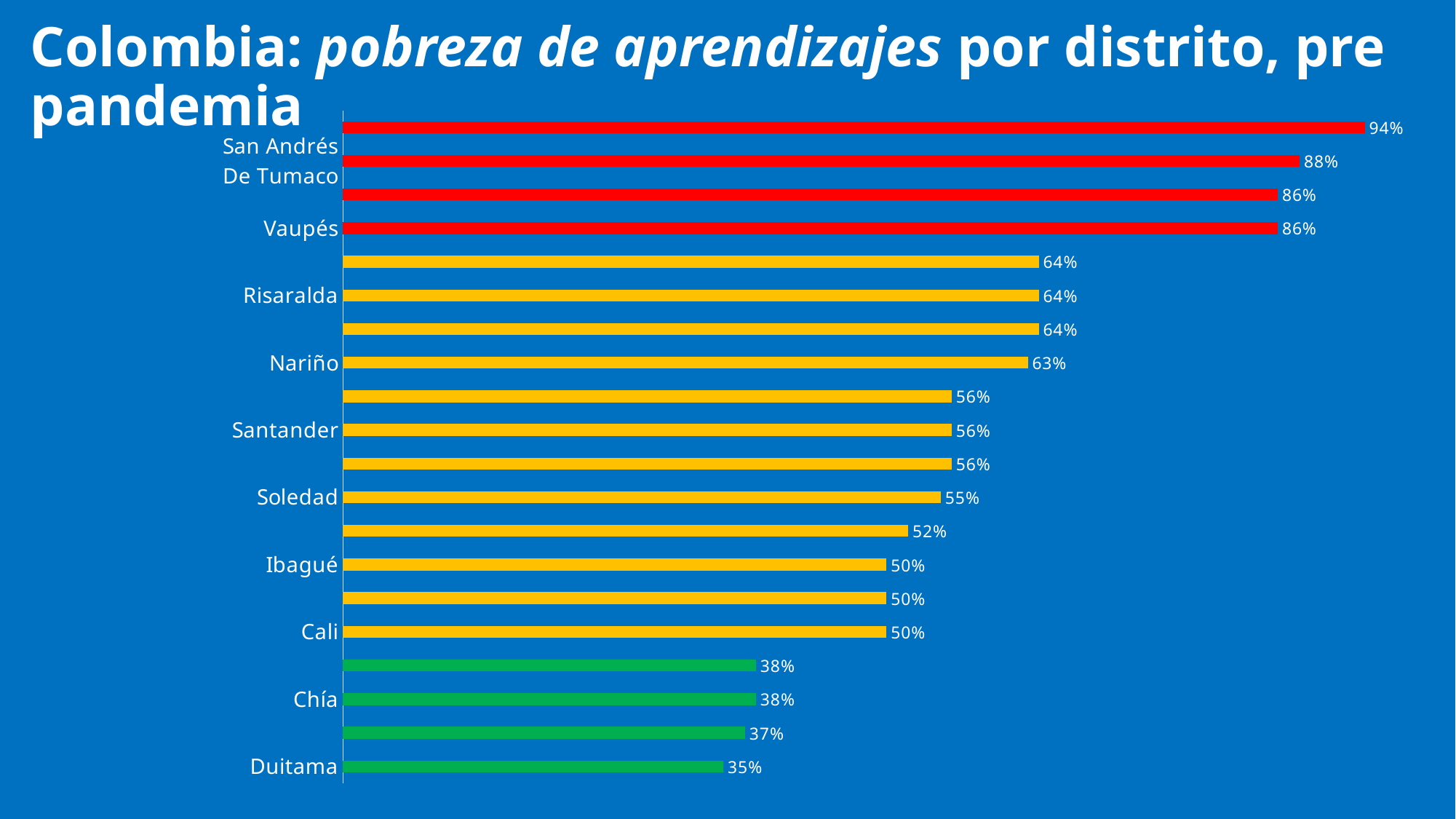
What is the value for Duitama? 35% What is the difference between the values for Risaralda and Cali? 14 percentage points How many bars are plotted in the chart? 20 Which is larger, the value for Soledad or the value for Ibagué? Soledad What is the value for Santander? 56% What is the value for Nariño? 63% What kind of chart is shown on the slide? Bar chart What colour is the bar for Duitama? Green What is the value for Risaralda? 64% What is the value for Vaupés? 86% What is the value for Cali? 50% Which labelled district has the lowest value? Duitama